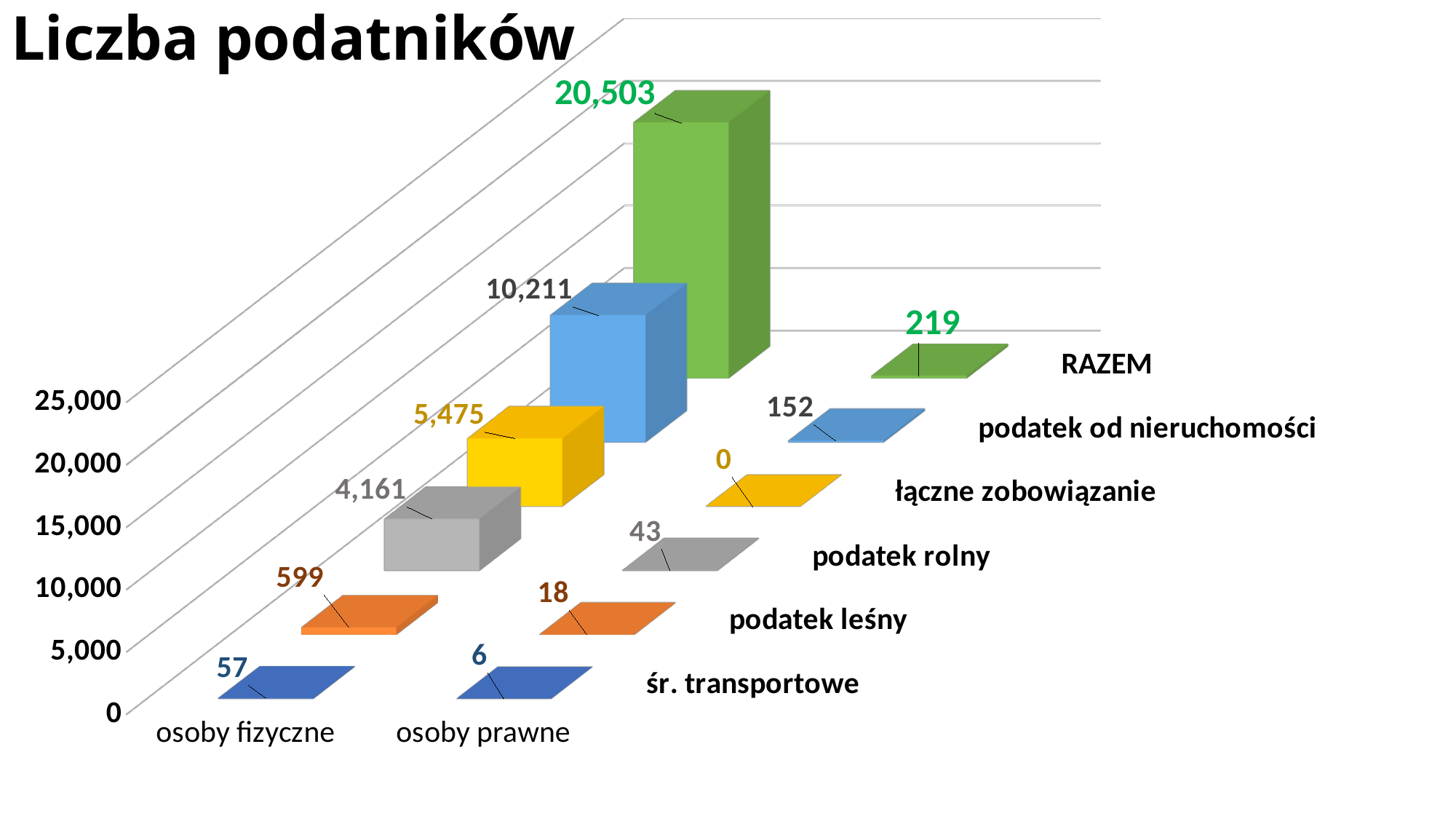
Which is larger: the podatek leśny value for osoby fizyczne or the podatek rolny value for osoby prawne? podatek leśny for osoby fizyczne How many categories are shown on the x axis? 2 What kind of chart is shown on the slide? bar chart What is the difference between the RAZEM values for osoby fizyczne and osoby prawne? 20,284 What is the value for osoby fizyczne in the RAZEM series? 20,503 What is the title of the chart? Liczba podatników What is the value for osoby prawne in the podatek od nieruchomości series? 152 What is the value for osoby fizyczne in the podatek rolny series? 4,161 Which series has the lowest value for osoby fizyczne? śr. transportowe Is the value for osoby fizyczne in the podatek od nieruchomości series greater or less than 15,000? less Which series has the highest value for osoby prawne? RAZEM What is the value for osoby prawne in the łączne zobowiązanie series? 0